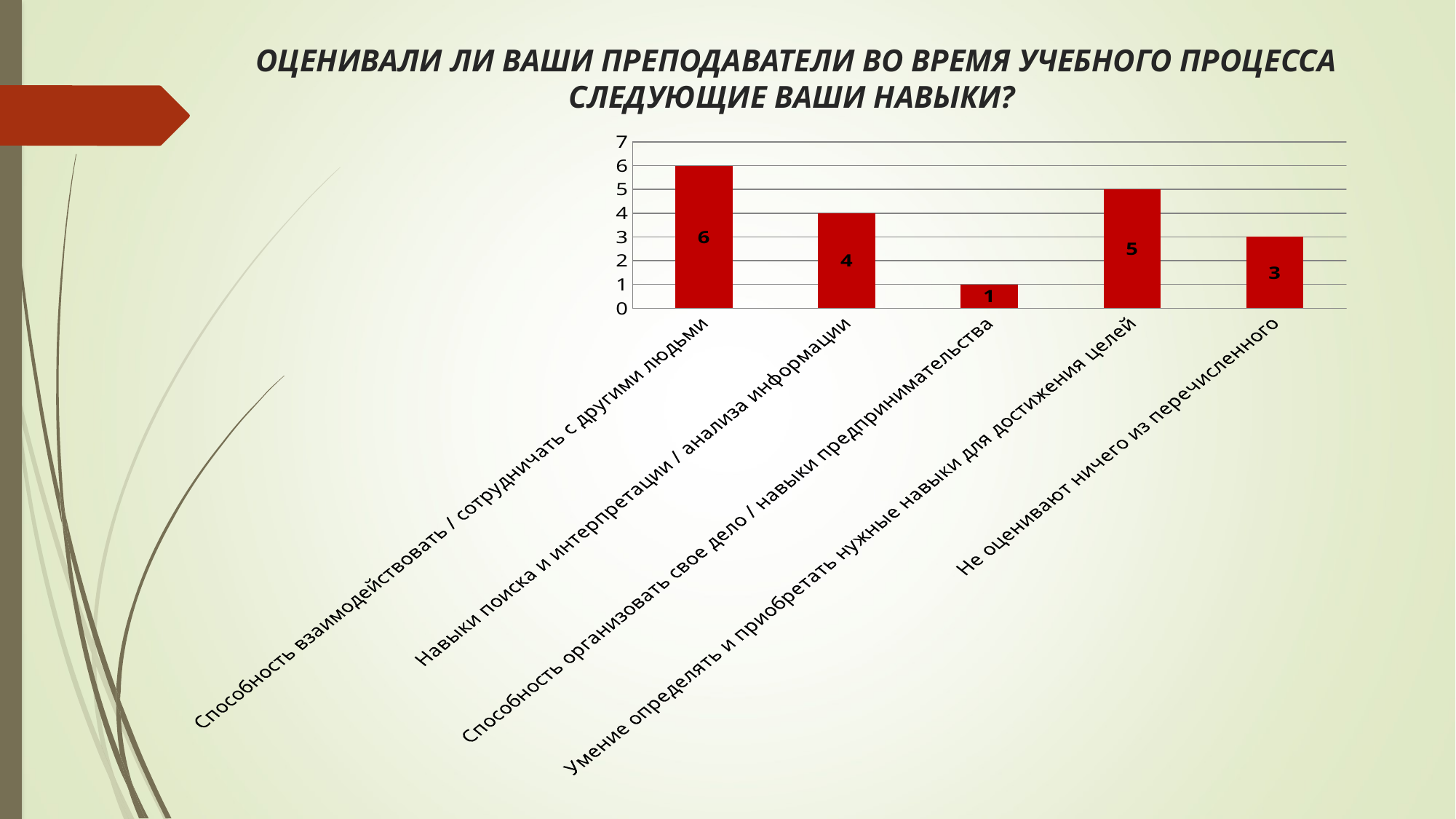
How many categories are shown on the chart? 5 Which is larger: the value for "Навыки поиска и интерпретации / анализа информации" or the value for "Умение определять и приобретать нужные навыки для достижения целей"? Умение определять и приобретать нужные навыки для достижения целей What is the value for "Не оценивают ничего из перечисленного"? 3 What is the difference between the values for "Способность взаимодействовать / сотрудничать с другими людьми" and "Не оценивают ничего из перечисленного"? 3 What kind of chart is shown on the slide? Bar chart Which category has the highest value? Способность взаимодействовать / сотрудничать с другими людьми What is the value for "Навыки поиска и интерпретации / анализа информации"? 4 What is the value for "Умение определять и приобретать нужные навыки для достижения целей"? 5 Which category has the lowest value? Способность организовать свое дело / навыки предпринимательства What is the value for "Способность организовать свое дело / навыки предпринимательства"? 1 What is the title of the slide? ОЦЕНИВАЛИ ЛИ ВАШИ ПРЕПОДАВАТЕЛИ ВО ВРЕМЯ УЧЕБНОГО ПРОЦЕССА СЛЕДУЮЩИЕ ВАШИ НАВЫКИ? What is the value for "Способность взаимодействовать / сотрудничать с другими людьми"? 6